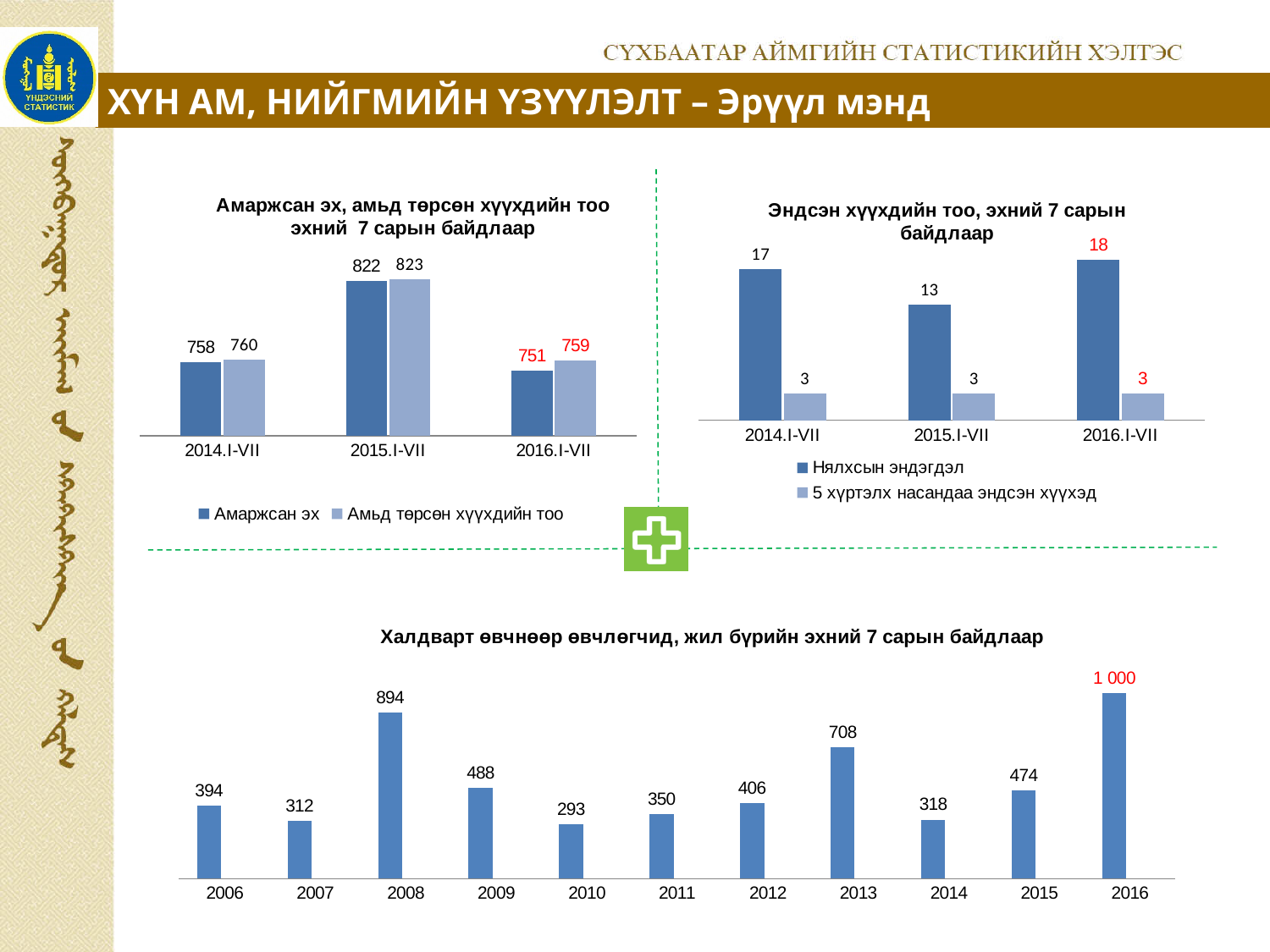
In the bottom chart 'Халдварт өвчнөөр өвчлөгчид, жил бүрийн эхний 7 сарын байдлаар', how many years are shown on the x axis? 11 In the top-right chart 'Эндсэн хүүхдийн тоо, эхний 7 сарын байдлаар', what is the value for Нялхсын эндэгдэл in 2016.I-VII? 18 In the bottom chart 'Халдварт өвчнөөр өвчлөгчид, жил бүрийн эхний 7 сарын байдлаар', what is the difference between the values for 2008 and 2007? 582 In the top-right chart 'Эндсэн хүүхдийн тоо, эхний 7 сарын байдлаар', what is the value for 5 хүртэлх насандаа эндсэн хүүхэд in 2014.I-VII? 3 In the top-left chart 'Амаржсан эх, амьд төрсөн хүүхдийн тоо эхний 7 сарын байдлаар', what is the value for Амаржсан эх in 2015.I-VII? 822 In the top-right chart 'Эндсэн хүүхдийн тоо, эхний 7 сарын байдлаар', which period has the lowest value for Нялхсын эндэгдэл? 2015.I-VII In the bottom chart 'Халдварт өвчнөөр өвчлөгчид, жил бүрийн эхний 7 сарын байдлаар', which year has the lowest value? 2010 In the bottom chart 'Халдварт өвчнөөр өвчлөгчид, жил бүрийн эхний 7 сарын байдлаар', which year has the highest value? 2016 In the top-left chart 'Амаржсан эх, амьд төрсөн хүүхдийн тоо эхний 7 сарын байдлаар', what is the difference between Амьд төрсөн хүүхдийн тоо and Амаржсан эх in 2016.I-VII? 8 In the top-left chart 'Амаржсан эх, амьд төрсөн хүүхдийн тоо эхний 7 сарын байдлаар', what is the value for Амьд төрсөн хүүхдийн тоо in 2016.I-VII? 759 In the top-left chart 'Амаржсан эх, амьд төрсөн хүүхдийн тоо эхний 7 сарын байдлаар', how many series does the legend list? 2 In the bottom chart 'Халдварт өвчнөөр өвчлөгчид, жил бүрийн эхний 7 сарын байдлаар', what is the value for 2013? 708